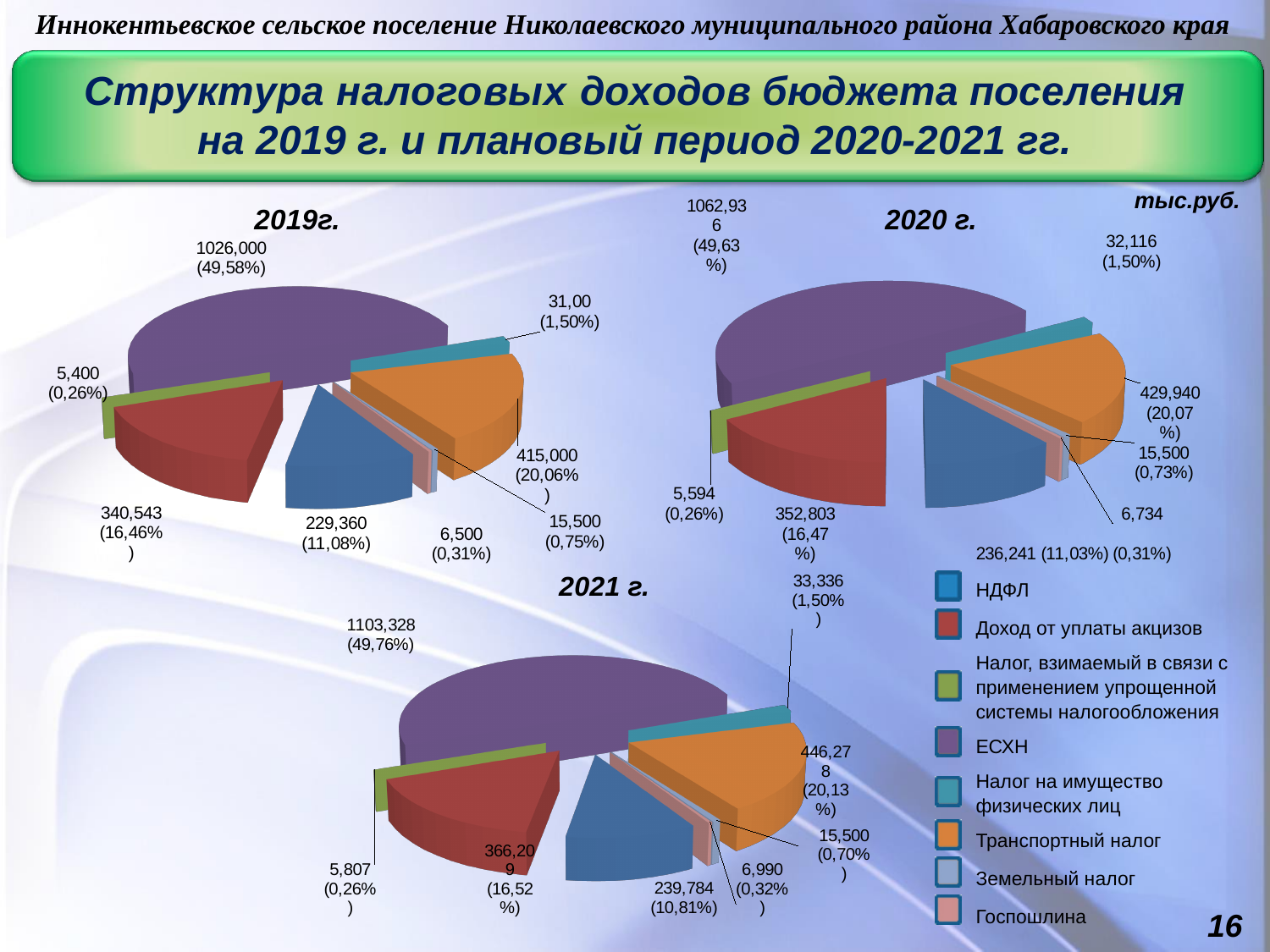
In the 2021 chart, what is the value of the Доход от уплаты акцизов (red) slice? 366,209 In the 2019 chart, what is the value and share of the largest slice (ЕСХН)? 1026,000 (49,58%) In the 2020 chart, what is the value of the НДФЛ (blue) slice? 236,241 How many pie charts are on the slide? 3 In the 2020 chart, what is the value of the largest slice (ЕСХН)? 1062,936 Which is larger in the 2021 chart: the Транспортный налог slice (446,278) or the Доход от уплаты акцизов slice (366,209)? Транспортный налог How many entries does the legend list? 8 In the 2019 chart, what is the value of the Транспортный налог (orange) slice? 415,000 What unit of measurement is indicated on the slide for the chart values? тыс.руб. Which category has the smallest share in the 2019 chart? Налог, взимаемый в связи с применением упрощенной системы налогообложения (5,400, 0,26%) What type of charts are shown on the slide? Pie charts In the 2021 chart, what share does the largest slice (ЕСХН) have? 49,76%